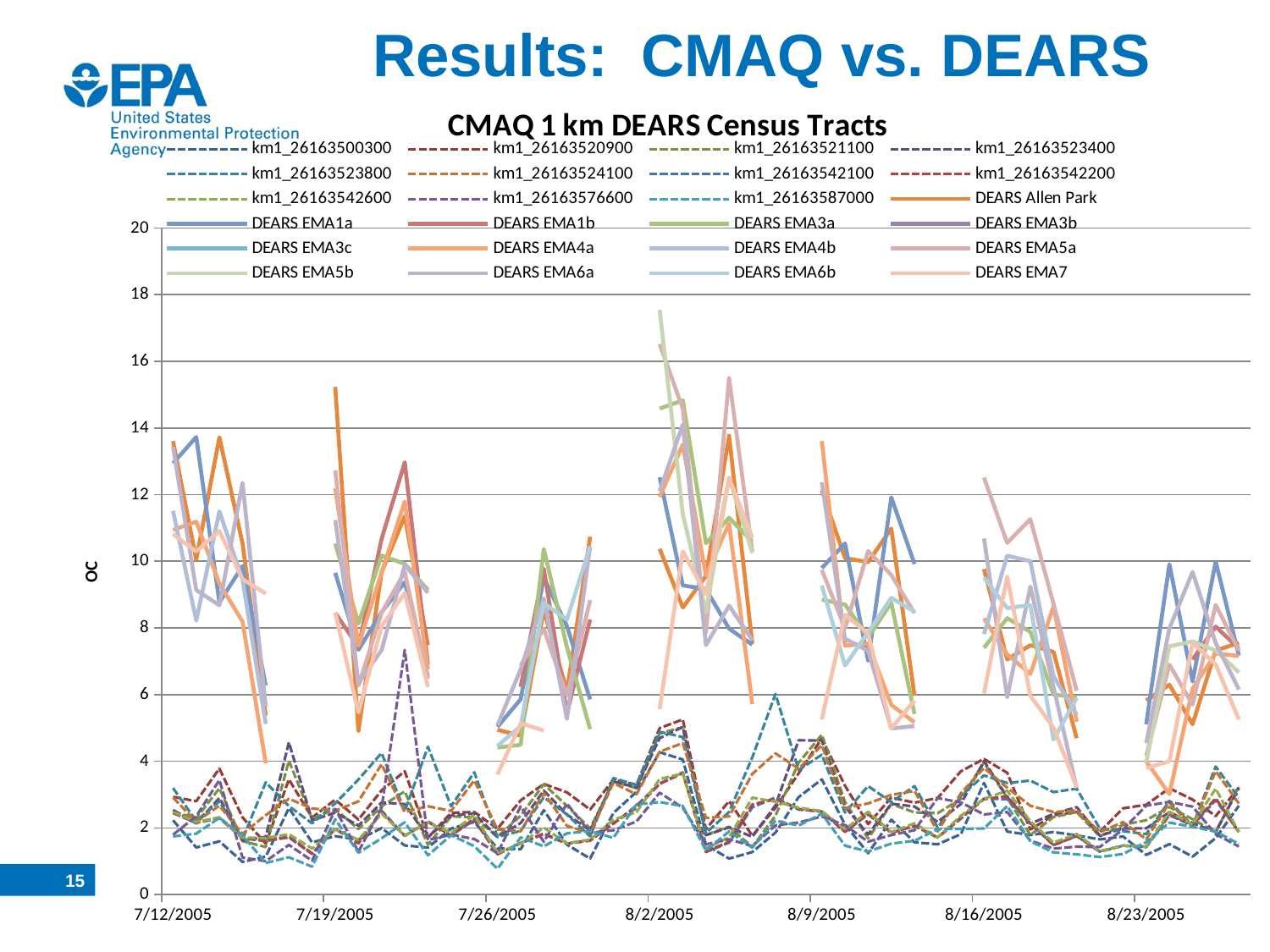
Is the highest value plotted on the chart greater or less than 16? greater What kind of chart is shown on the slide? line chart Is the highest value plotted on the chart greater or less than 18? less How many series in the legend have names beginning with "km1_"? 11 What is the title of the chart? CMAQ 1 km DEARS Census Tracts How many series does the chart legend list in total? 24 How many series in the legend have names beginning with "DEARS"? 13 What is the label on the vertical axis of the chart? OC